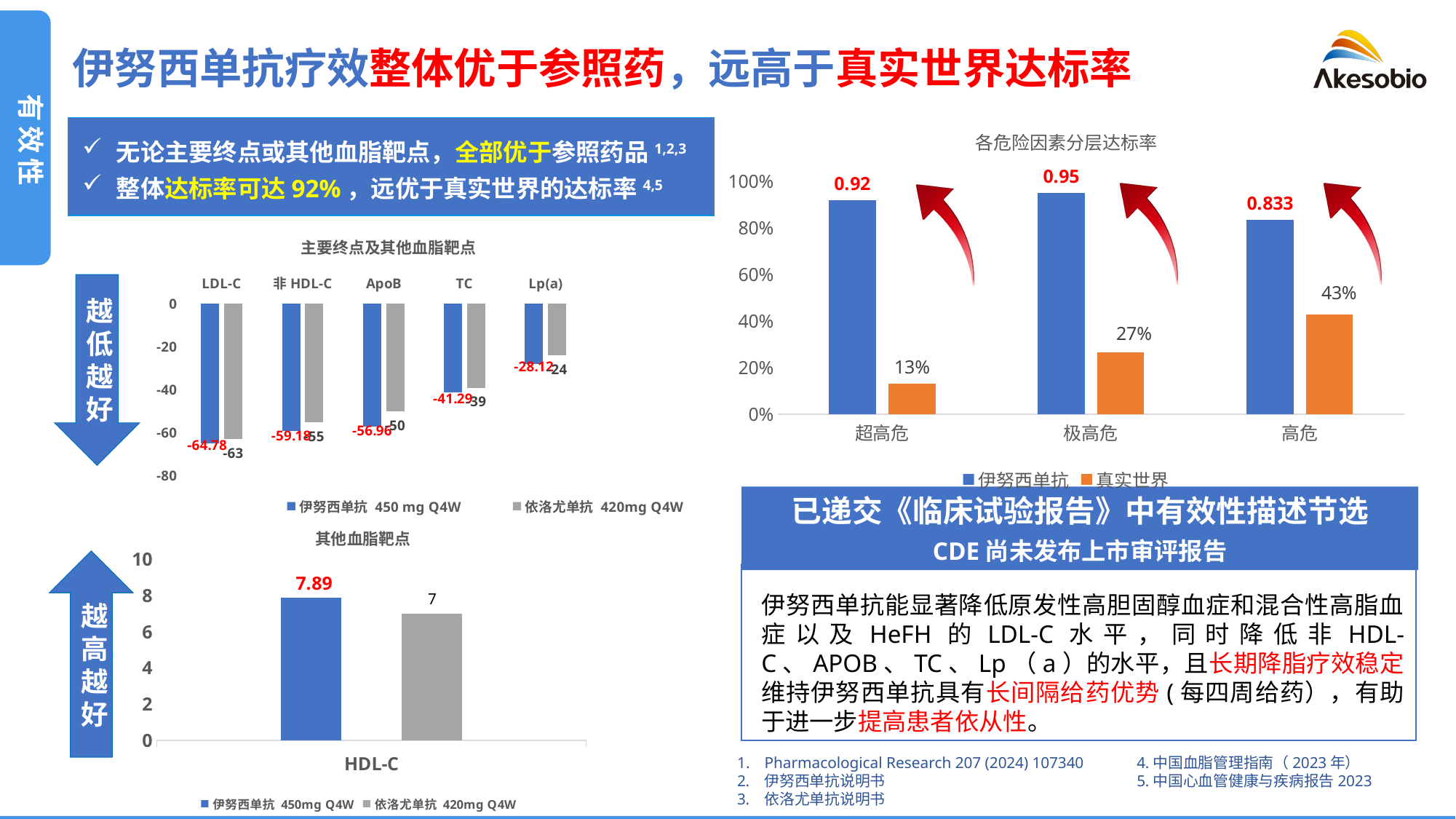
In the chart titled 主要终点及其他血脂靶点, what is the value for 依洛尤单抗 420mg Q4W for ApoB? -50 In the chart titled 其他血脂靶点, what is the difference between the 伊努西单抗 450mg Q4W value and the 依洛尤单抗 420mg Q4W value for HDL-C? 0.89 In the chart titled 各危险因素分层达标率, which category has the lowest 真实世界 value? 超高危 In the chart titled 主要终点及其他血脂靶点, how many categories are shown? 5 In the chart titled 各危险因素分层达标率, what is the value for 伊努西单抗 in the 极高危 category? 0.95 In the chart titled 其他血脂靶点, which series has the larger value for HDL-C? 伊努西单抗 450mg Q4W In the chart titled 各危险因素分层达标率, what is the value for 真实世界 in the 高危 category? 43% In the chart titled 各危险因素分层达标率, how many series does the legend list? 2 In the chart titled 各危险因素分层达标率, is the 真实世界 value for 极高危 greater or less than 40%? less In the chart titled 主要终点及其他血脂靶点, what is the value for 伊努西单抗 450 mg Q4W for LDL-C? -64.78 In the chart titled 各危险因素分层达标率, how many categories are shown on the x axis? 3 In the chart titled 主要终点及其他血脂靶点, what kind of chart is it? bar chart